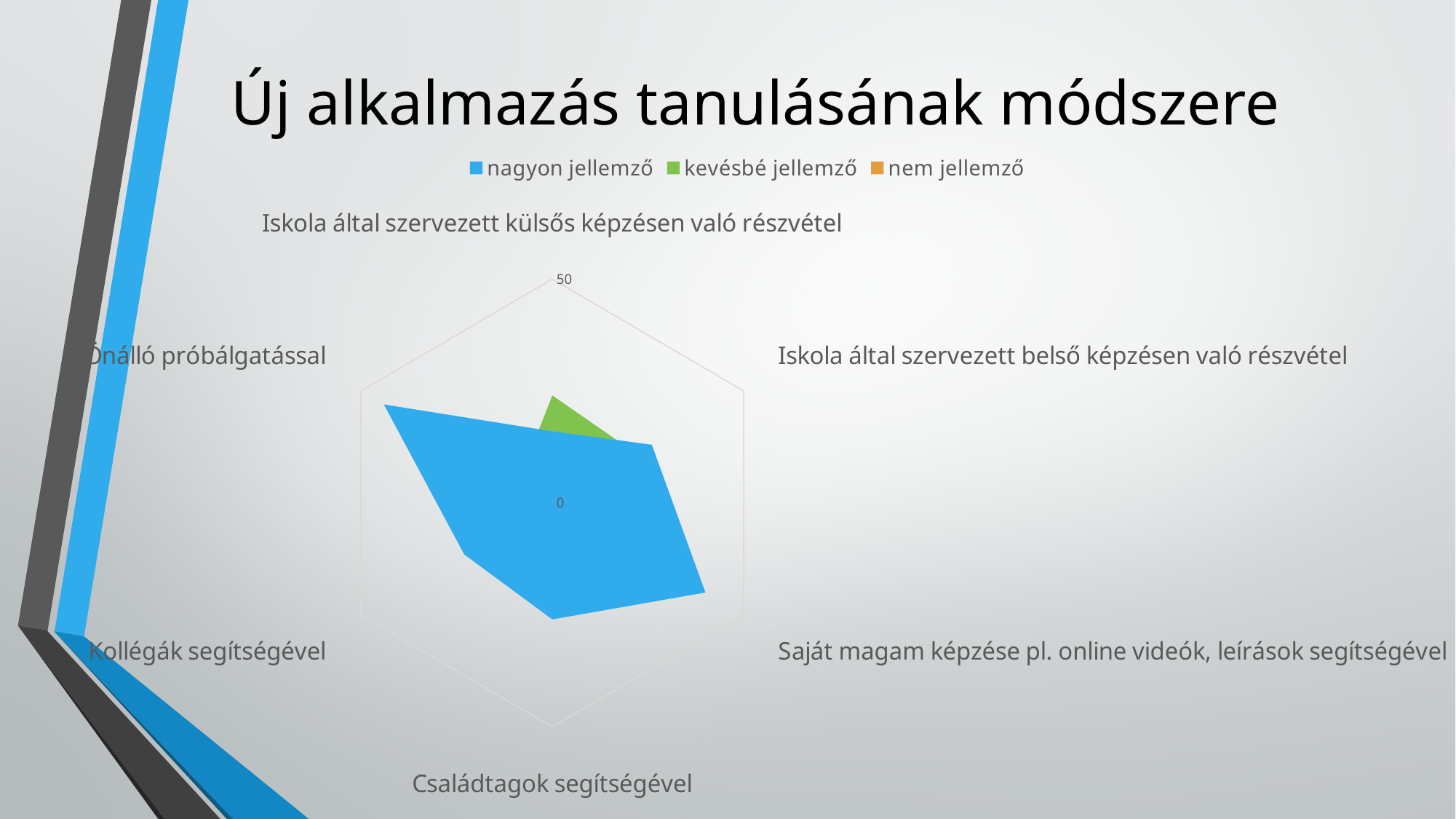
For 'Iskola által szervezett külsős képzésen való részvétel', which series has the larger value: 'nagyon jellemző' or 'kevésbé jellemző'? kevésbé jellemző Is the 'nagyon jellemző' value for 'Önálló próbálgatással' greater or less than 50? less Which series is shown in blue? nagyon jellemző How many categories (axes) does the radar chart have? 6 For the 'nagyon jellemző' series, which is larger: 'Önálló próbálgatással' or 'Iskola által szervezett külsős képzésen való részvétel'? Önálló próbálgatással Is the 'nagyon jellemző' value for 'Családtagok segítségével' greater or less than 50? less Which category has the highest value for the 'nagyon jellemző' series? Önálló próbálgatással Which category has the lowest value for the 'nagyon jellemző' series? Iskola által szervezett külsős képzésen való részvétel What is the title of the slide's chart? Új alkalmazás tanulásának módszere For the 'nagyon jellemző' series, which is larger: 'Saját magam képzése pl. online videók, leírások segítségével' or 'Iskola által szervezett külsős képzésen való részvétel'? Saját magam képzése pl. online videók, leírások segítségével What kind of chart is shown on the slide? radar chart How many series does the legend list? 3